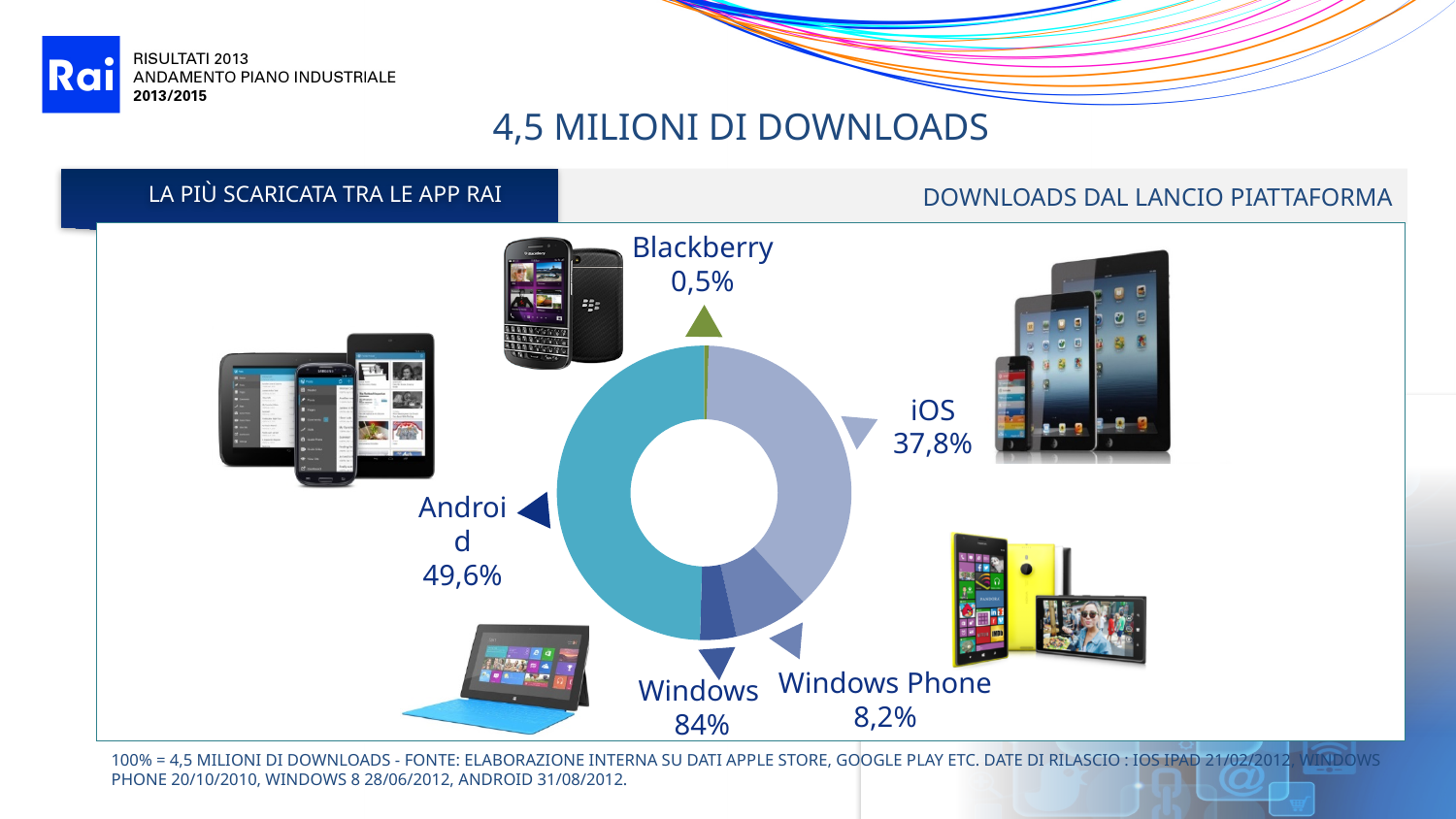
According to the footnote, what total does 100% of the chart represent? 4,5 milioni di downloads What is the share shown for Windows Phone in the chart? 8,2% What percentage of downloads is attributed to Android in the chart? 49,6% Which has a larger share of downloads, Android or iOS? Android What percentage is shown for Blackberry in the chart? 0,5% What type of chart is used to show the download shares by platform? Donut (pie) chart By how many percentage points does the Android share exceed the iOS share? 11,8 By how many percentage points does the iOS share exceed the Windows Phone share? 29,6 Which platform has the smallest share of downloads in the chart? Blackberry What share of downloads does iOS account for in the donut chart? 37,8% How many platforms are shown as segments in the chart? 5 Which has a larger share of downloads, iOS or Windows Phone? iOS